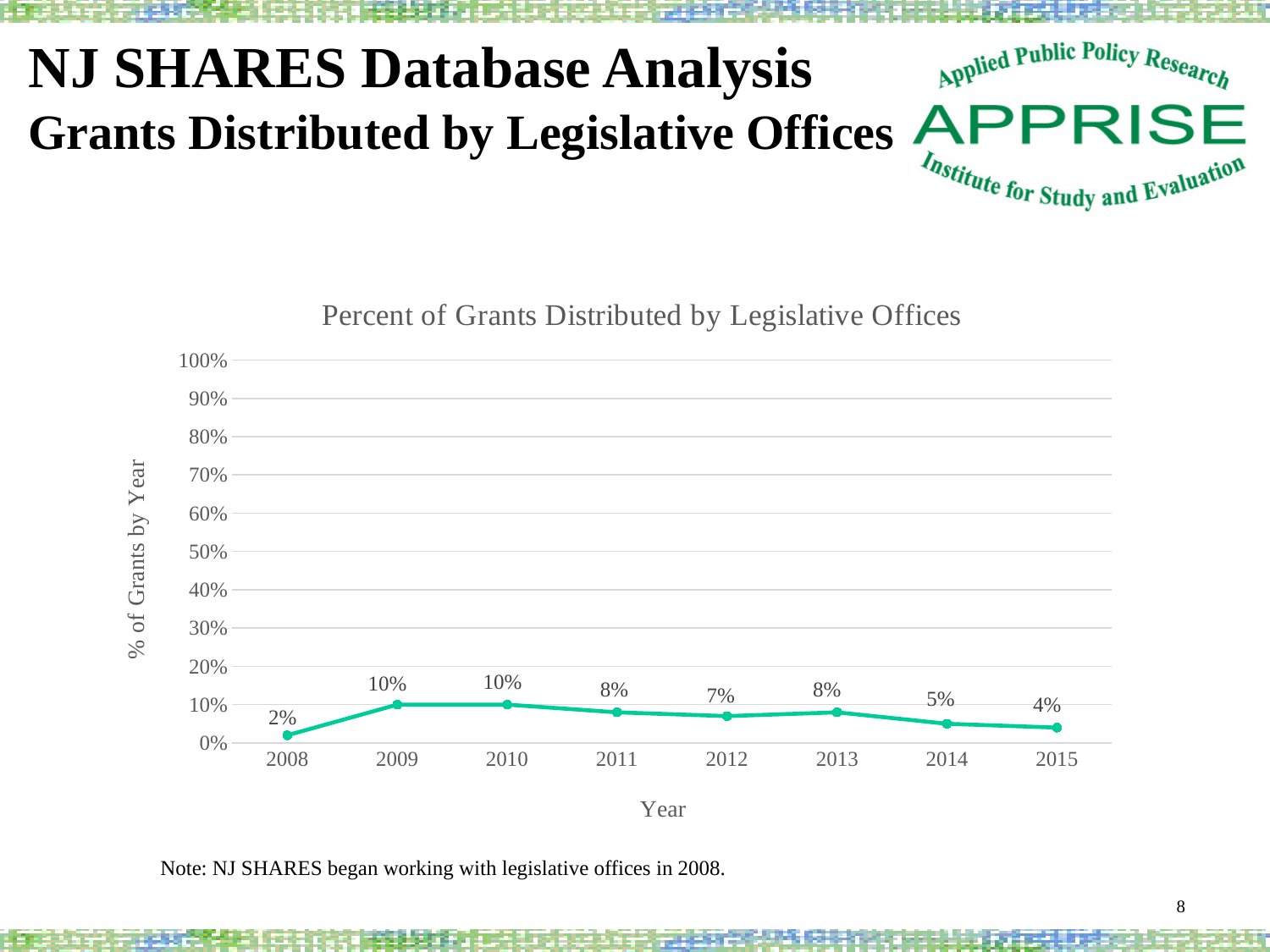
What kind of chart is shown on the slide? line chart How many years are plotted on the chart? 8 What is the title of the chart? Percent of Grants Distributed by Legislative Offices Which is larger, the value for 2012 or the value for 2014? 2012 What is the difference between the values for 2011 and 2014? 3% What percent of grants were distributed by legislative offices in 2008? 2% What is the value for 2013? 8% What is the value for 2015? 4% Is the value for 2010 greater or less than 50%? less What is the difference between the values for 2009 and 2015? 6% Which year has the lowest percent of grants distributed by legislative offices? 2008 Do the values rise or fall from 2013 to 2015? fall